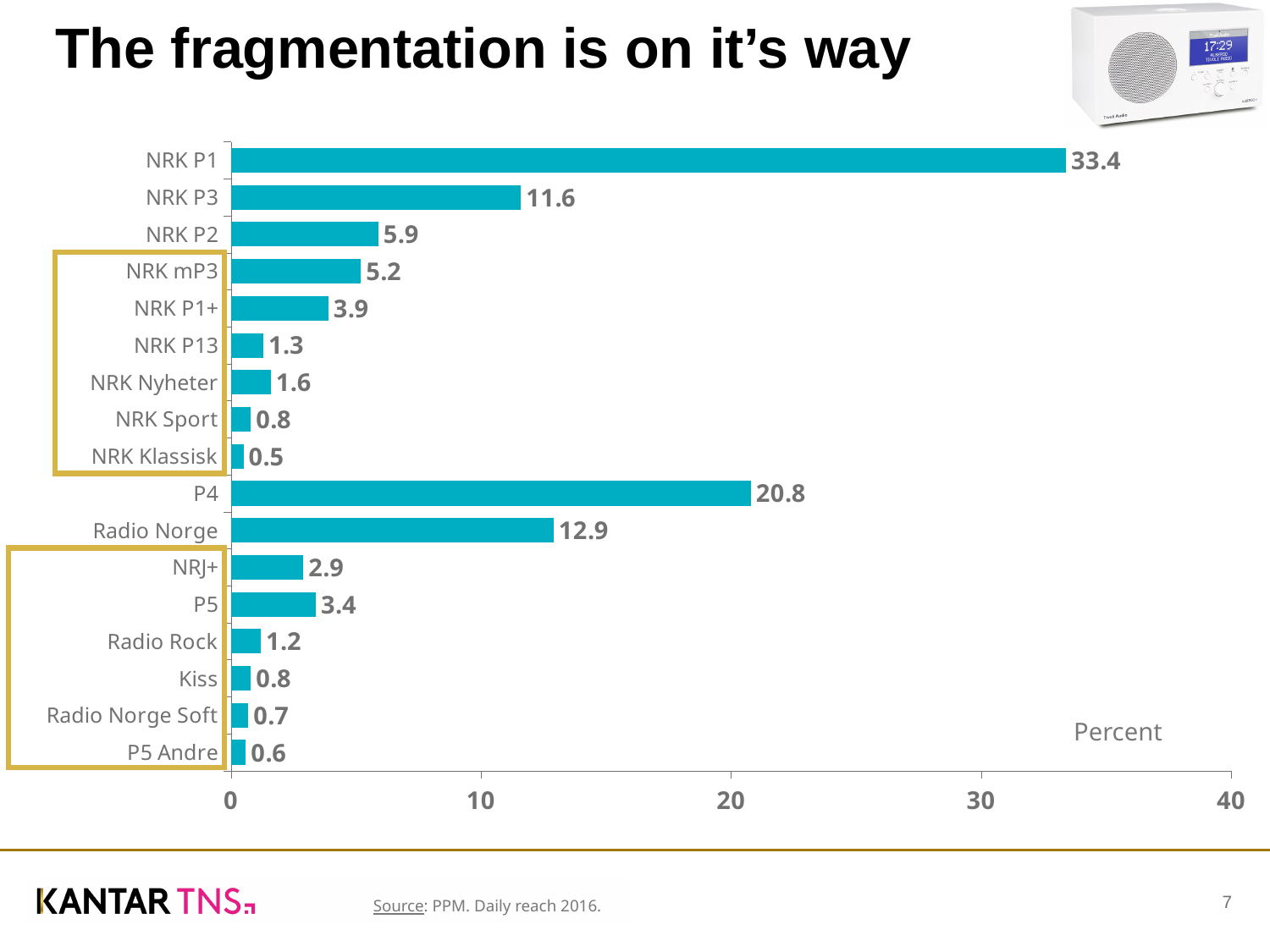
What is the value for Radio Norge Soft? 0.7 What is the value for P4? 20.8 What unit label is shown near the x axis of the chart? Percent Is the value for NRK P1 greater or less than 30? greater What kind of chart is shown on the slide? bar chart Which is larger, the value for NRK P3 or the value for Radio Norge? Radio Norge Which category has the highest value? NRK P1 What is the difference between the values for P4 and Radio Norge? 7.9 Which category has the lowest value? NRK Klassisk What is the value for NRK P1? 33.4 How many categories are shown in the chart? 17 What is the difference between the values for NRK P1 and NRK P3? 21.8